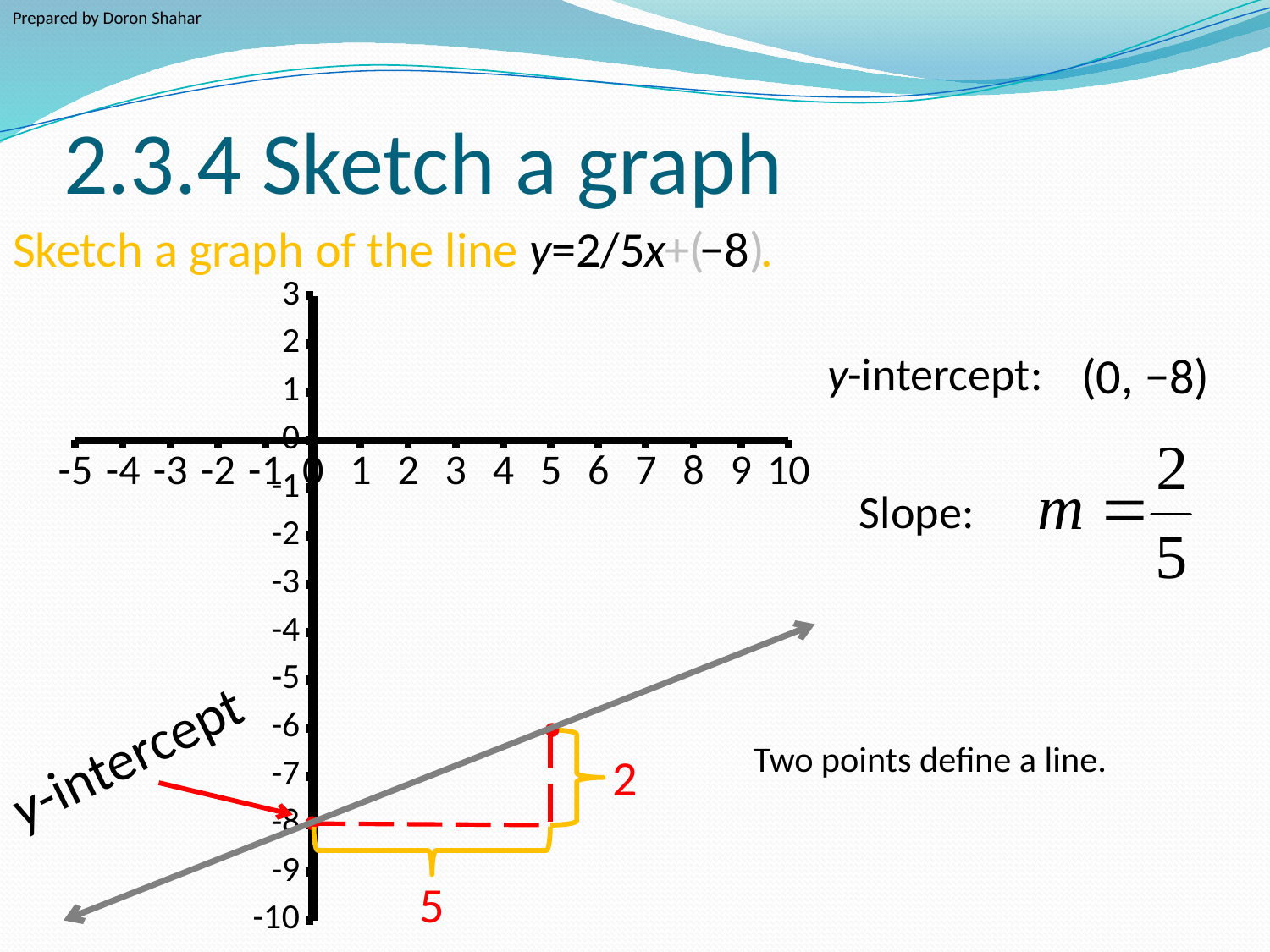
What is the slope of the line shown on the graph? 2/5 Does the line rise or fall as x increases? rise How many points are marked on the line in the graph? 2 Which is larger, the y value of the line at x = 5 or at x = 0? at x = 5 What kind of chart is shown on the slide? line chart What is the lowest value shown on the y axis of the graph? -10 What is the y-intercept of the line shown on the graph? (0, −8) Is the y value of the line at x = 0 greater or less than -5? less What is the rise labelled on the graph between the two marked points? 2 What is the run labelled on the graph between the two marked points? 5 Is the y value of the line at x = 5 greater or less than -7? greater What is the highest value shown on the x axis of the graph? 10